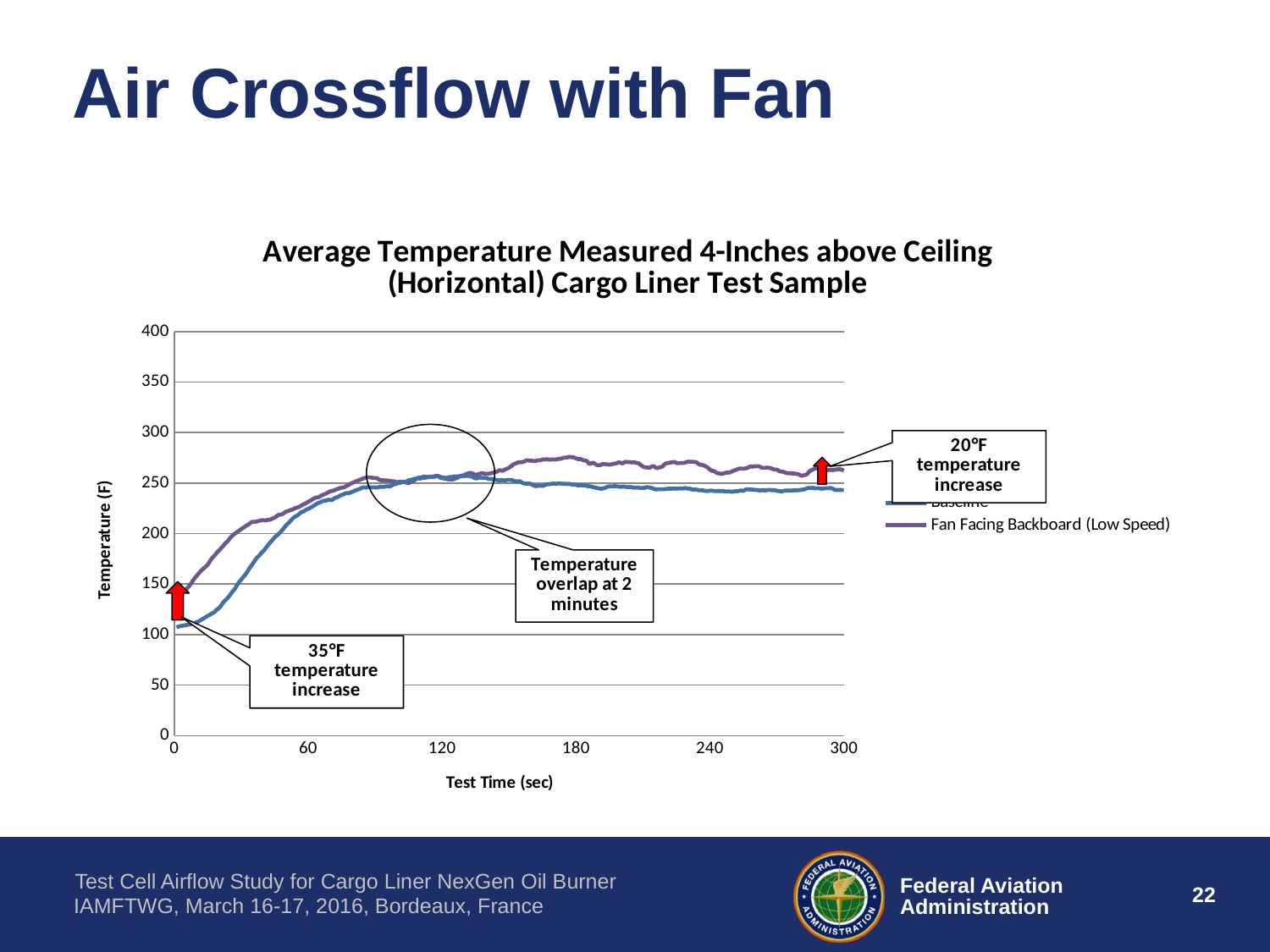
At 30 seconds, which series shows the higher temperature, Baseline or Fan Facing Backboard (Low Speed)? Fan Facing Backboard (Low Speed) How many series does the chart's legend list? 2 What is the maximum value shown on the Temperature (F) axis? 400 Is the Baseline temperature at 0 seconds greater or less than 150? less What kind of chart is shown on the slide? Line chart What is the label of the x axis of the chart? Test Time (sec) What is the title of the chart? Average Temperature Measured 4-Inches above Ceiling (Horizontal) Cargo Liner Test Sample Is the Fan Facing Backboard (Low Speed) temperature at 300 seconds greater or less than 250? greater Does the Baseline temperature rise or fall over the first 60 seconds of test time? Rise Is the Fan Facing Backboard (Low Speed) temperature at 180 seconds greater or less than 250? greater At 300 seconds, which series shows the higher temperature, Baseline or Fan Facing Backboard (Low Speed)? Fan Facing Backboard (Low Speed)